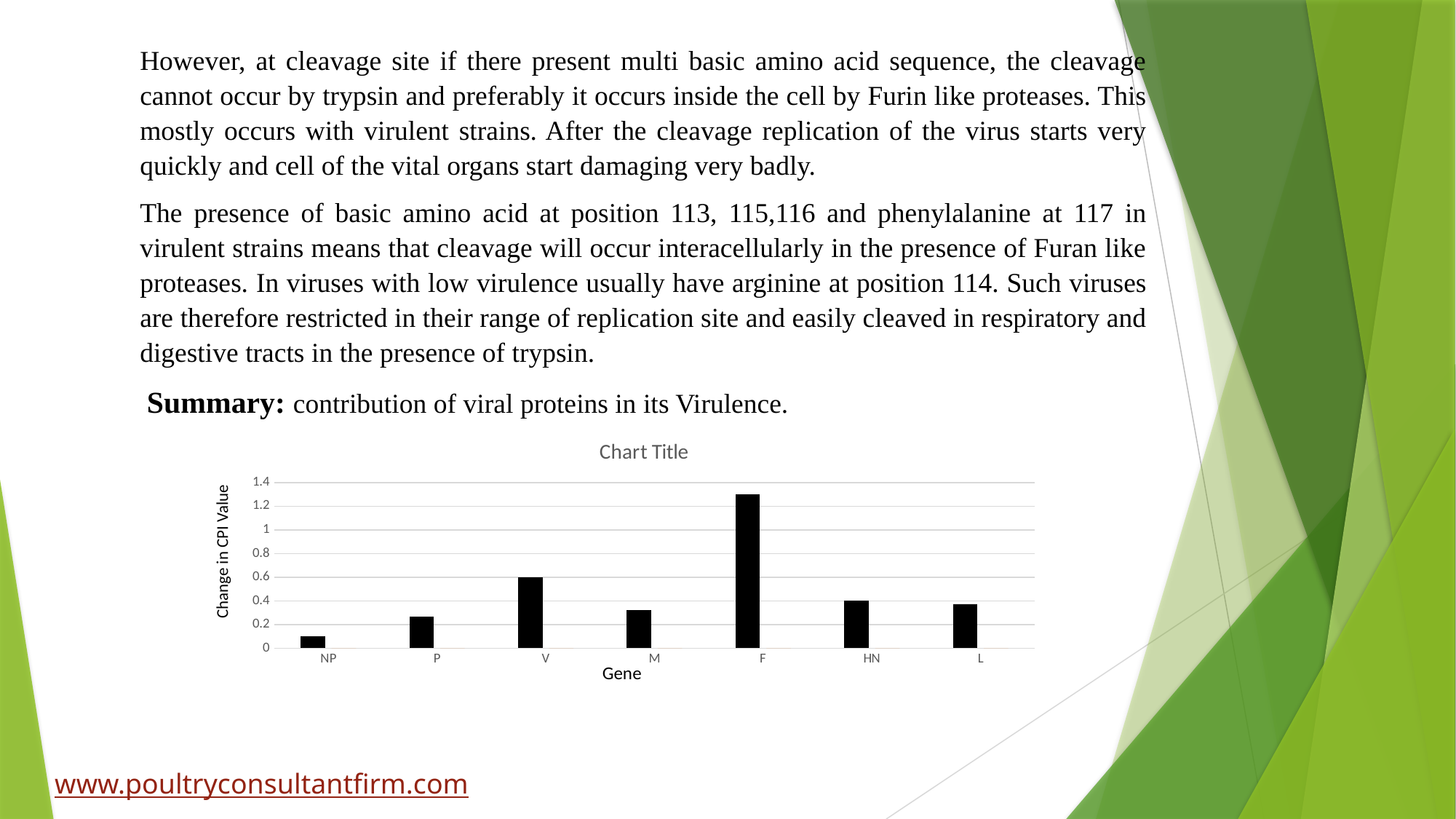
Is the change in CPI value for P greater or less than 0.4? less What is the label of the vertical axis of the chart? Change in CPI Value Is the change in CPI value for NP greater or less than 0.2? less Which gene has a larger change in CPI value, V or M? V What kind of chart is shown on the slide? bar chart Which gene has the lowest change in CPI value? NP Which gene has a larger change in CPI value, F or HN? F Which gene has the highest change in CPI value? F How many genes are plotted on the x axis of the chart? 7 Is the change in CPI value for F greater or less than 1.2? greater What is the label of the horizontal axis of the chart? Gene